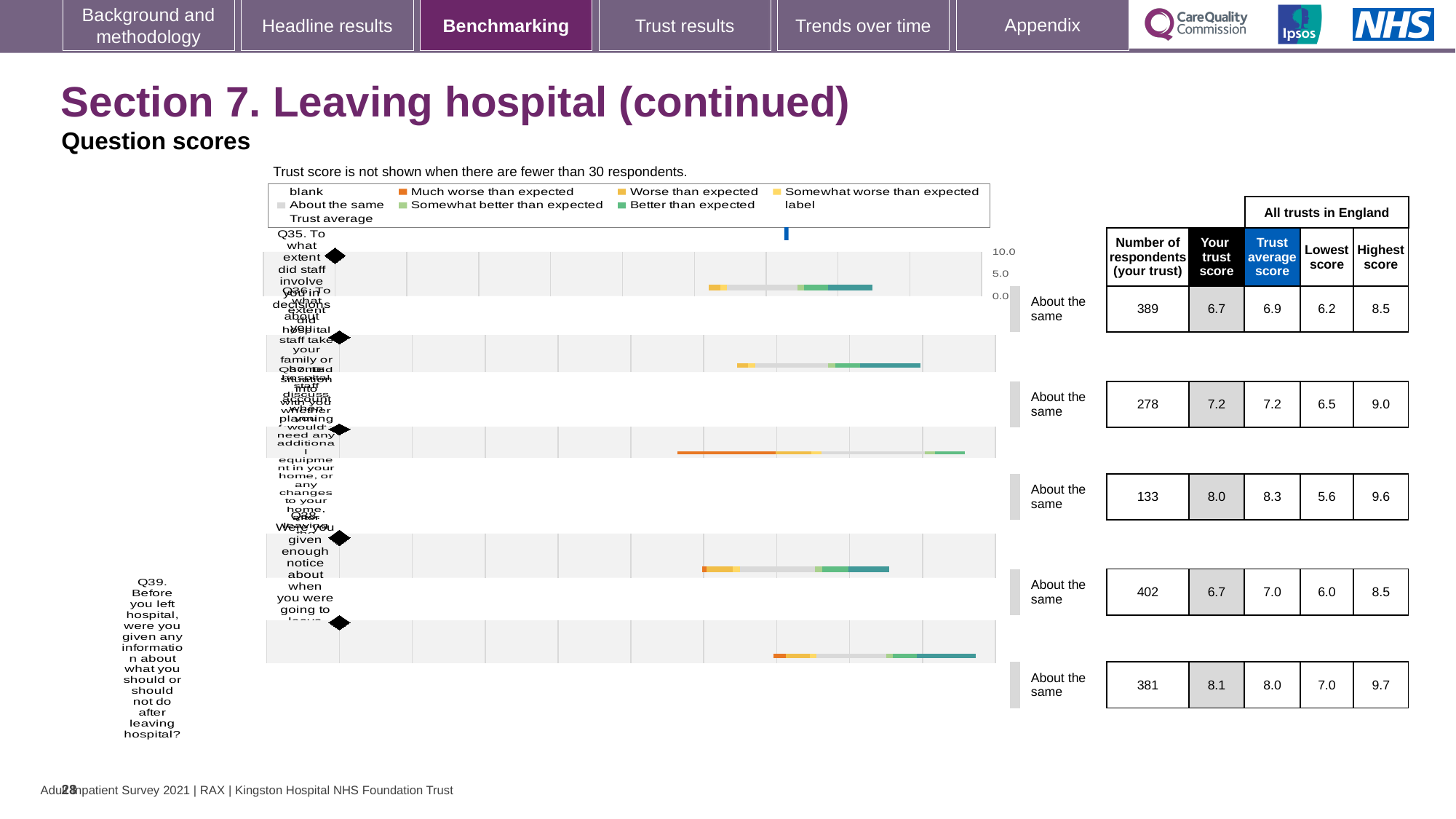
How many questions are shown on the chart? 5 What is the difference between the trust average score and 'Your trust score' for Q37? 0.3 What is the difference between the highest score and the lowest score for Q39? 2.7 What is the number of respondents (your trust) for Q35? 389 What is the 'Your trust score' for Q39? 8.1 For Q39, which is larger: 'Your trust score' or the trust average score? Your trust score What kind of chart is shown on the slide? Bar chart Which question has the fewest respondents (your trust)? Q37 Which question has the highest 'Your trust score'? Q39 What is the highest score across all trusts in England for Q36? 9.0 Which question has the largest number of respondents (your trust)? Q38 What is the trust average score for Q37? 8.3